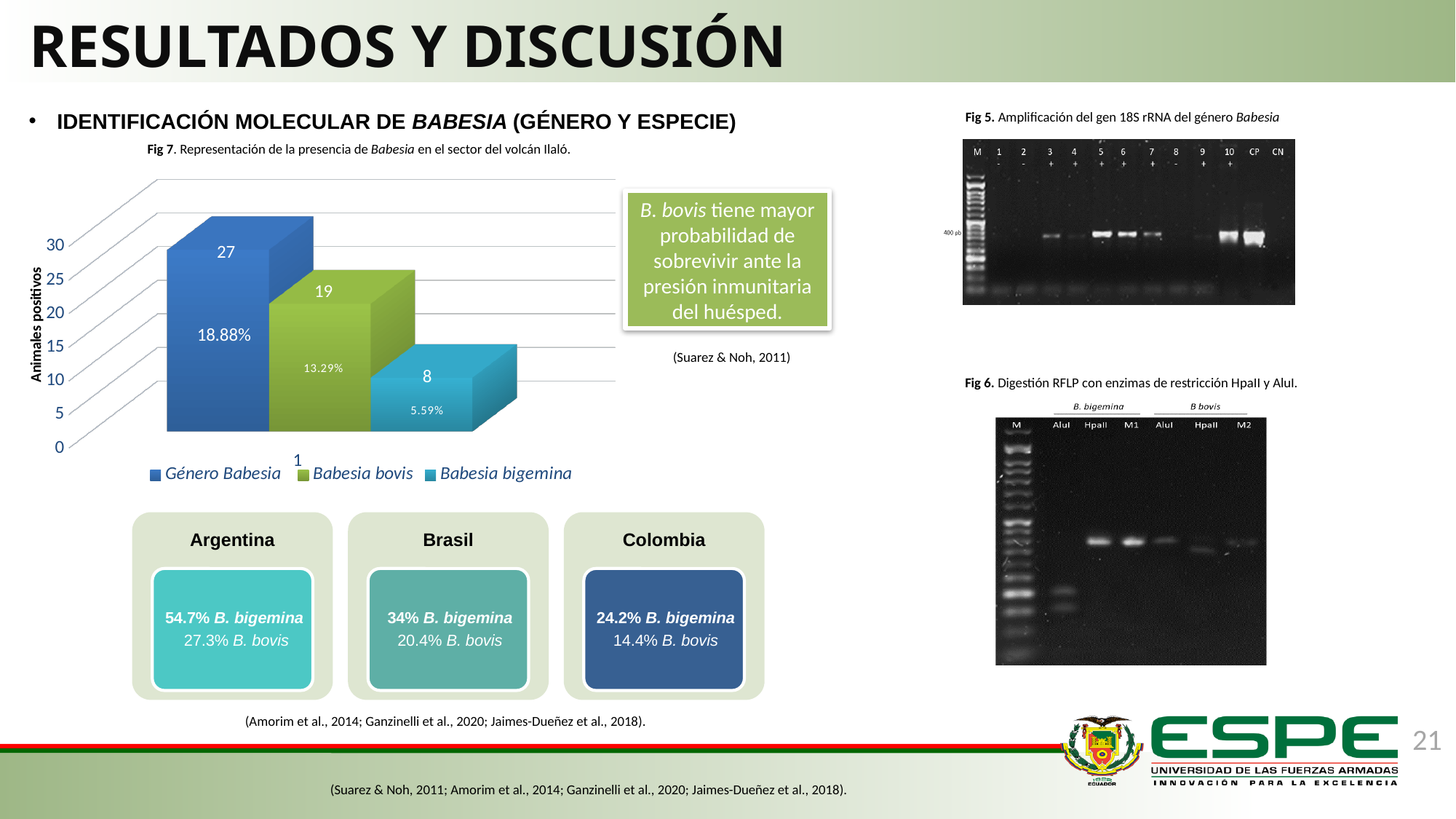
In the Fig 7 chart, how many positive animals are shown for Babesia bigemina? 8 In the Fig 7 chart, how many positive animals are shown for Género Babesia? 27 In the Fig 7 chart, what percentage is printed on the Babesia bigemina bar? 5.59% What kind of chart is shown in Fig 7? bar chart In the Fig 7 chart, what percentage is printed on the Babesia bovis bar? 13.29% What is the label of the vertical axis in the Fig 7 chart? Animales positivos How many series does the legend of the Fig 7 chart list? 3 In the Fig 7 chart, which series has the highest number of positive animals? Género Babesia In the Fig 7 chart, what is the difference in positive animals between Babesia bovis and Babesia bigemina? 11 In the Fig 7 chart, which has more positive animals, Babesia bovis or Babesia bigemina? Babesia bovis In the Fig 7 chart, which series has the lowest number of positive animals? Babesia bigemina In the Fig 7 chart, how many positive animals are shown for Babesia bovis? 19